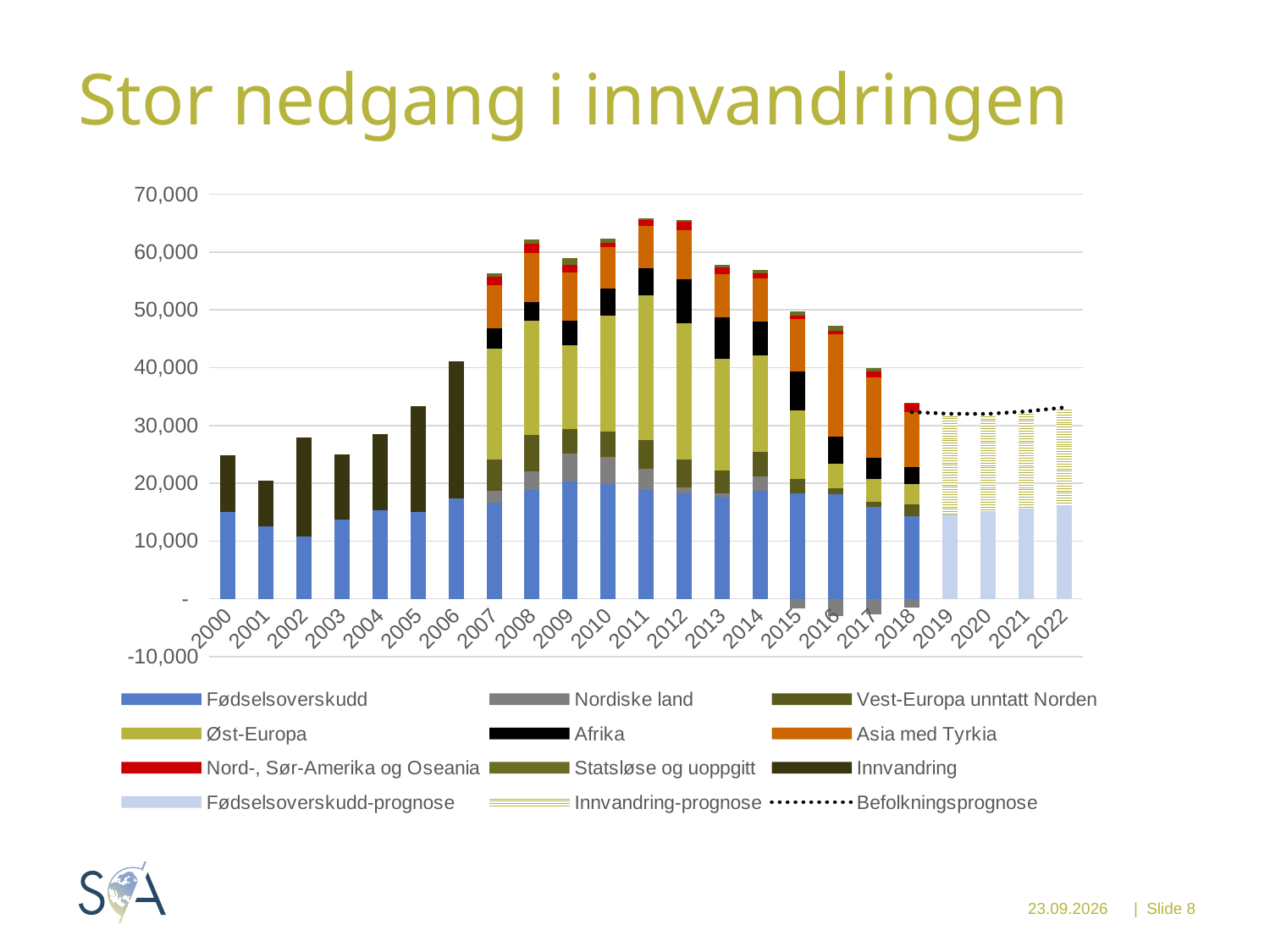
Is the total height of the stacked bar for 2001 greater or less than 25,000? less What is the title of the slide containing the chart? Stor nedgang i innvandringen Is the total height of the stacked bar for 2005 greater or less than 30,000? greater Which year has the taller total stacked bar, 2016 or 2017? 2016 Is the total height of the stacked bar for 2008 greater or less than 60,000? greater How many years are shown along the x axis of the chart? 23 What kind of chart is shown on the slide? Stacked bar chart Which legend entry is represented by the dotted line in the chart? Befolkningsprognose How many series does the chart's legend list? 12 Among the years 2000 to 2018, which year has the lowest total stacked bar? 2001 Do the total stacked bar heights rise or fall from 2012 to 2018? fall